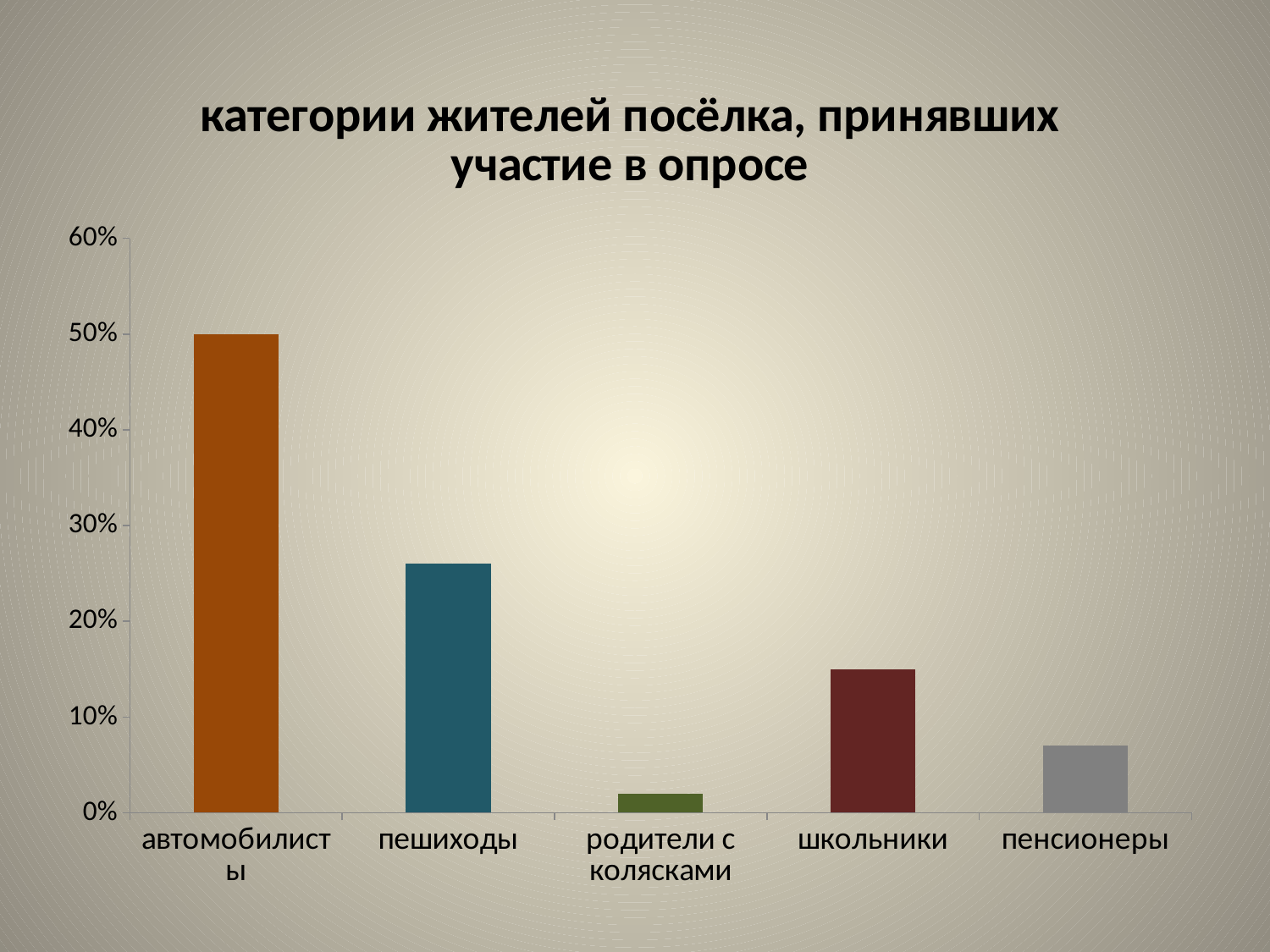
What is the value for автомобилисты? 50% Which is larger, the value for пешиходы or the value for школьники? пешиходы Which is larger, the value for школьники or the value for пенсионеры? школьники How many categories are shown in the chart? 5 Is the value for родители с колясками greater or less than 10%? less Is the value for пешиходы greater or less than 20%? greater What is the title of the chart? категории жителей посёлка, принявших участие в опросе Which category has the highest value? автомобилисты Which category has the lowest value? родители с колясками Is the value for пенсионеры greater or less than 10%? less What kind of chart is shown on the slide? bar chart